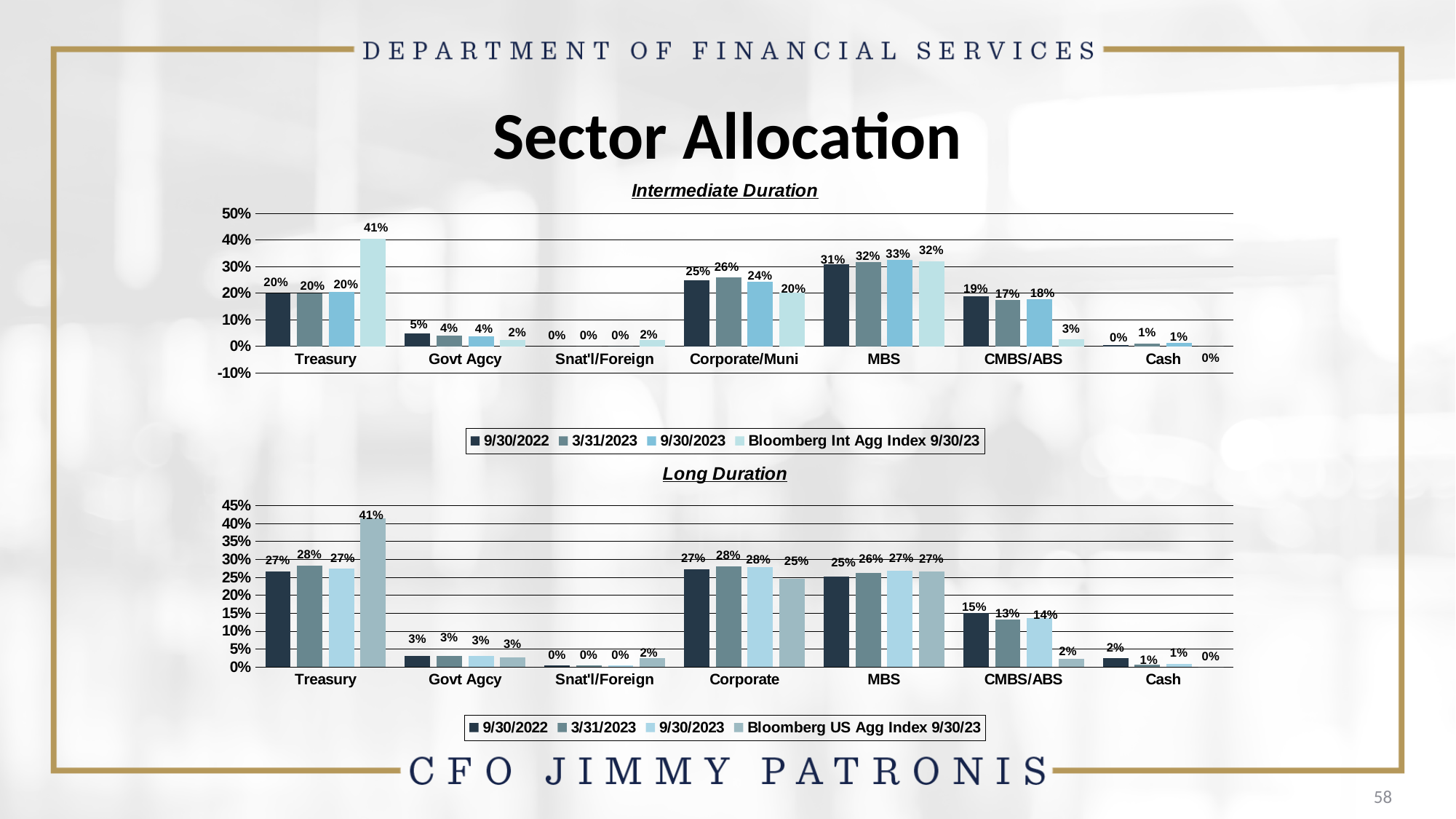
In the Long Duration chart, is the 9/30/2022 value for Treasury larger or the 9/30/2022 value for MBS? Treasury In the Intermediate Duration chart, how many categories are shown on the x axis? 7 In the Long Duration chart, what is the value for Corporate in the 3/31/2023 series? 28% In the Long Duration chart, how many series does the legend list? 4 In the Long Duration chart, what is the name of the fourth series in the legend? Bloomberg US Agg Index 9/30/23 In the Intermediate Duration chart, what is the difference between the 9/30/2023 value and the Bloomberg Int Agg Index 9/30/23 value for CMBS/ABS? 15% In the Intermediate Duration chart, which category has the highest value in the 9/30/2022 series? MBS In the Intermediate Duration chart, what is the value for MBS in the 9/30/2023 series? 33% In the Intermediate Duration chart, what is the Bloomberg Int Agg Index 9/30/23 value for Treasury? 41% In the Long Duration chart, which category has the lowest value in the Bloomberg US Agg Index 9/30/23 series? Cash In the Long Duration chart, what is the 9/30/2022 value for CMBS/ABS? 15% What kind of chart is the Long Duration chart? Bar chart